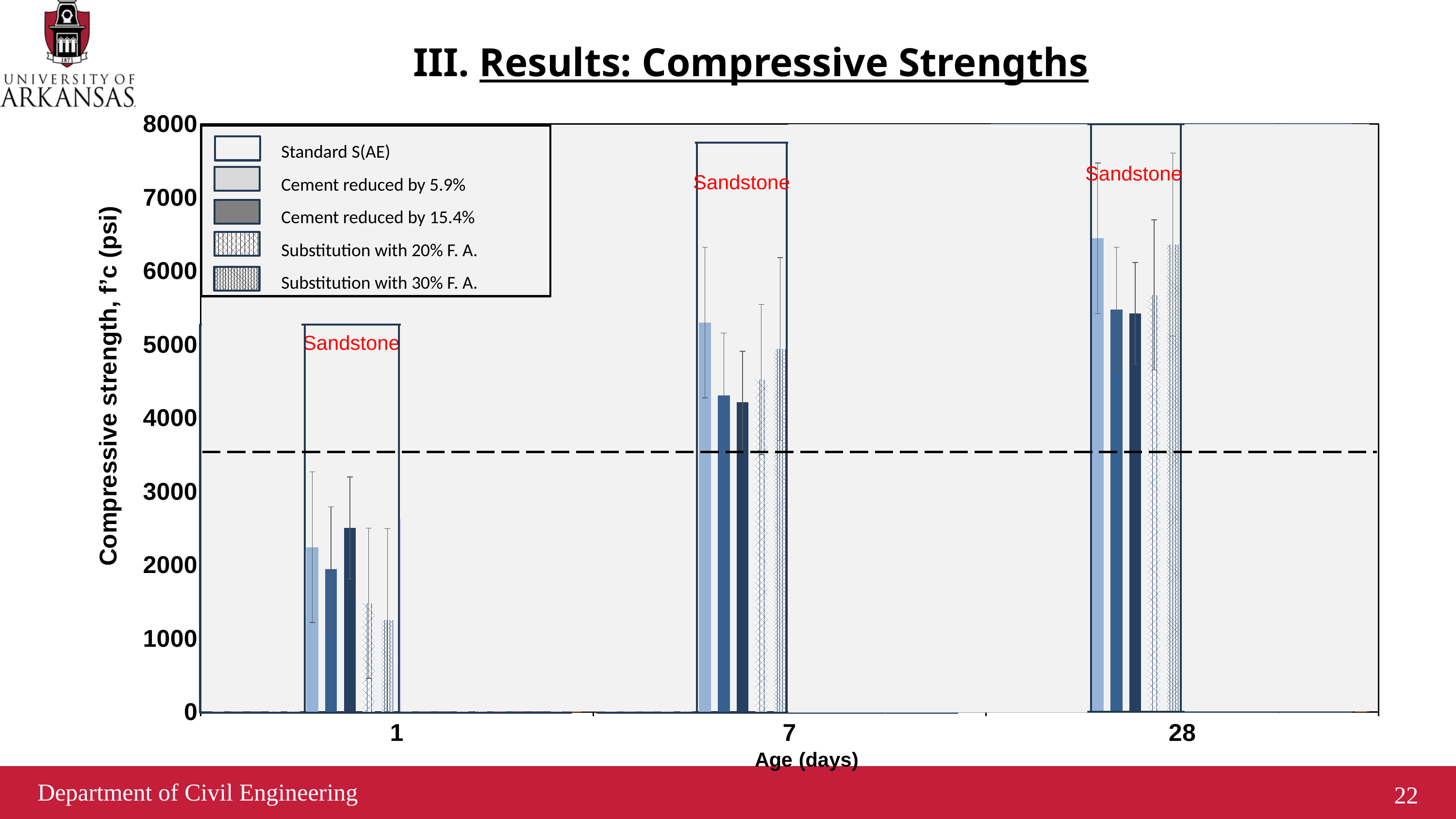
At 7 days, which is larger: Substitution with 20% F. A. or Substitution with 30% F. A.? Substitution with 30% F. A. Is the value for Substitution with 30% F. A. at 1 day greater or less than 2000? less Is the value for Standard S(AE) at 1 day greater or less than 3000? less Which series has the highest compressive strength at 1 day? Cement reduced by 15.4% Is the value for Standard S(AE) at 28 days greater or less than 6000? greater Which series has the lowest compressive strength at 1 day? Substitution with 30% F. A. How many age categories are shown on the x axis? 3 How many series does the legend list? 5 What kind of chart is shown on the slide? bar chart Does the compressive strength of the Standard S(AE) mix rise or fall as age increases from 1 to 28 days? rise What is the label of the y axis? Compressive strength, f'c (psi)